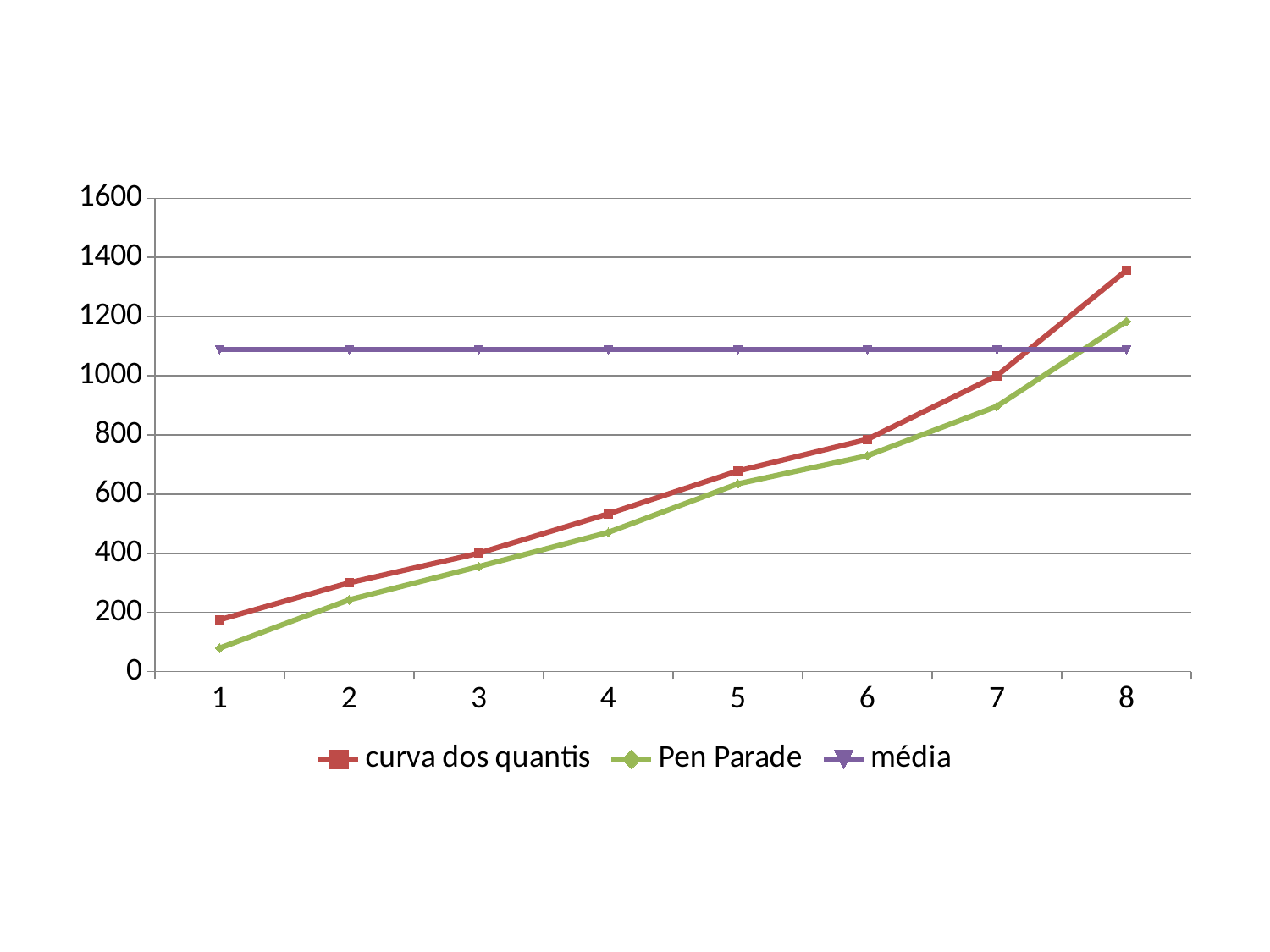
Is the value of 'média' greater or less than 1000? greater Is the value of 'Pen Parade' at x = 1 greater or less than 200? less How many series does the legend list? 3 At x = 8, which series has the higher value, 'curva dos quantis' or 'Pen Parade'? curva dos quantis At x = 7, which is larger, the 'curva dos quantis' value or the 'média' value? média Is the value of 'curva dos quantis' at x = 8 greater or less than 1200? greater Does the 'Pen Parade' series rise or fall along the x axis? rise Does the 'curva dos quantis' series rise or fall from x = 1 to x = 8? rise At which x value does 'Pen Parade' reach its lowest value? 1 How many points are plotted along the x axis for each series? 8 What kind of chart is shown on the slide? line chart Which series is shown as a flat horizontal line? média